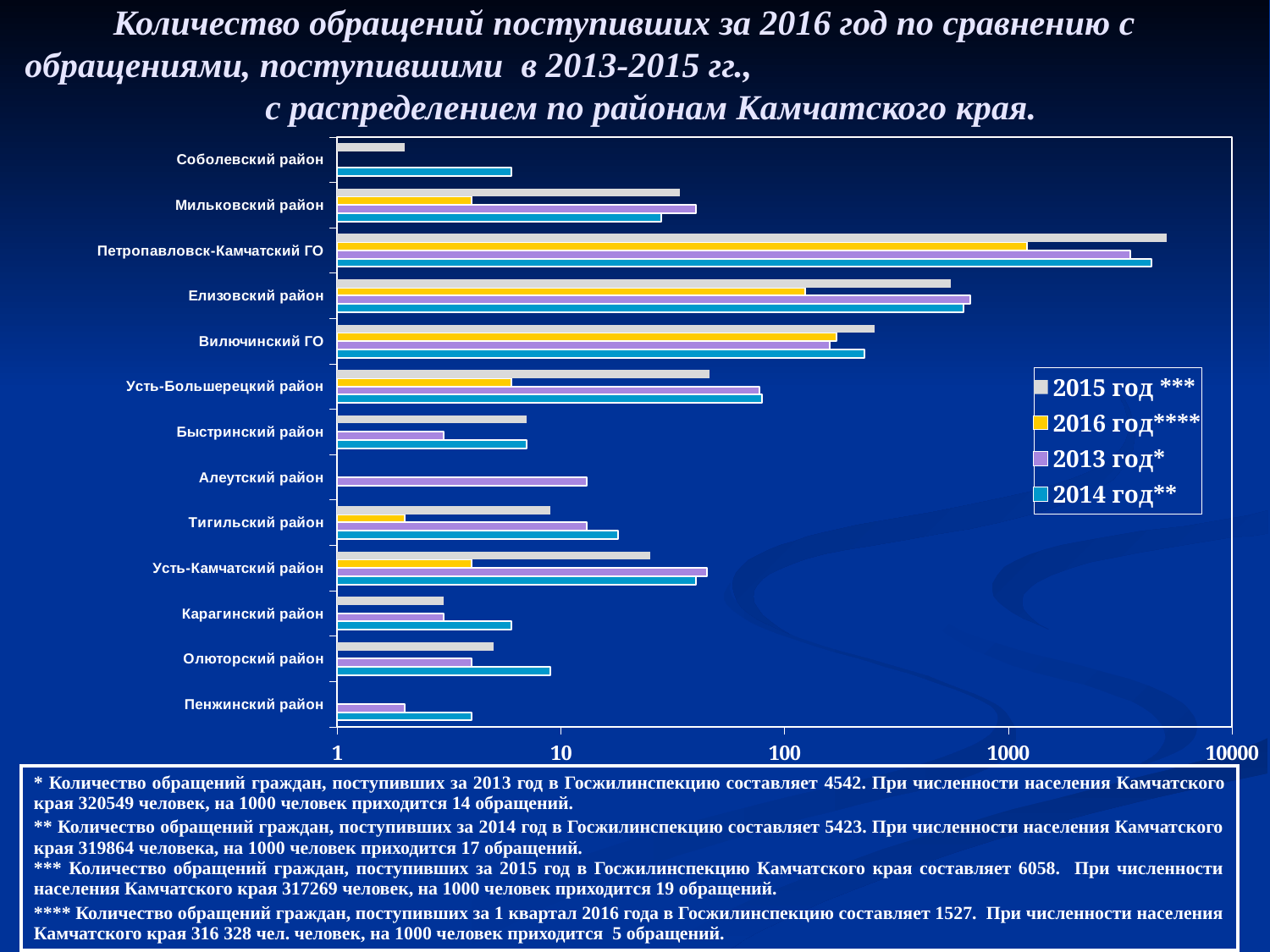
Which district has the highest value for the 2015 год series? Петропавловск-Камчатский ГО For Елизовский район, which is larger: the 2013 год value or the 2016 год value? 2013 год How many series does the chart legend list? 4 What are the four series listed in the chart legend? 2015 год ***, 2016 год****, 2013 год*, 2014 год** For Тигильский район, which is larger: the 2014 год value or the 2015 год value? 2014 год What kind of chart is shown on the slide? Bar chart Is the 2016 год value for Петропавловск-Камчатский ГО greater or less than 1000? greater Which district has the highest value for the 2016 год series? Петропавловск-Камчатский ГО How many districts (categories) are listed on the vertical axis of the chart? 13 Is the 2016 год value for Усть-Большерецкий район greater or less than 10? less Is the 2014 год value for Елизовский район greater or less than 100? greater